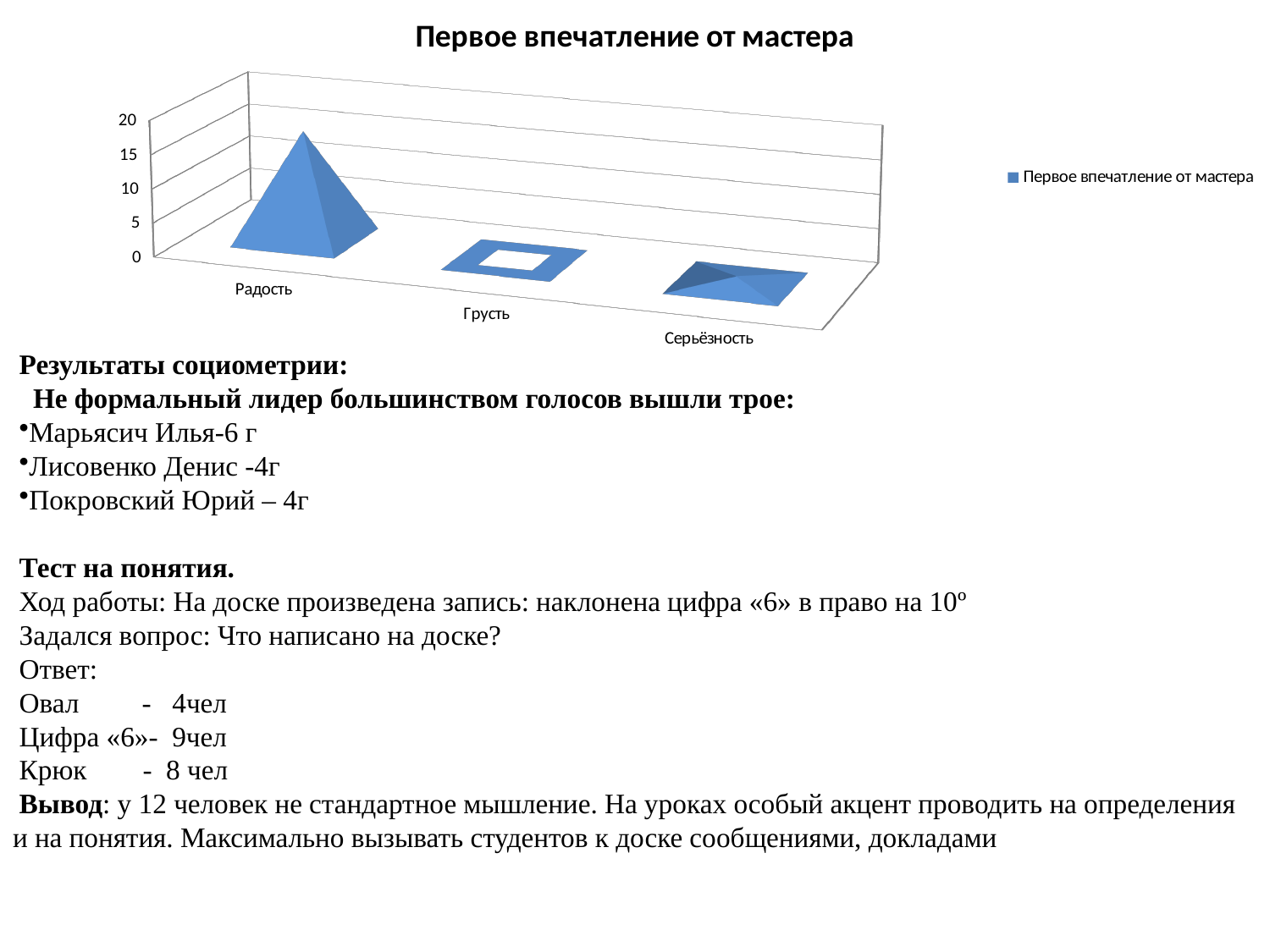
How many categories are shown on the chart's x axis? 3 Is the value for Серьёзность greater or less than 5? less Which category has the lowest value on the chart? Грусть What kind of chart is shown on the slide? bar chart Which is larger, the value for Серьёзность or the value for Грусть? Серьёзность Which category has the highest value on the chart? Радость Which is larger, the value for Радость or the value for Серьёзность? Радость What is the title of the chart? Первое впечатление от мастера Is the value for Радость greater or less than 10? greater How many series does the chart legend list? 1 Is the value for Грусть greater or less than 5? less What is the name of the series listed in the chart legend? Первое впечатление от мастера